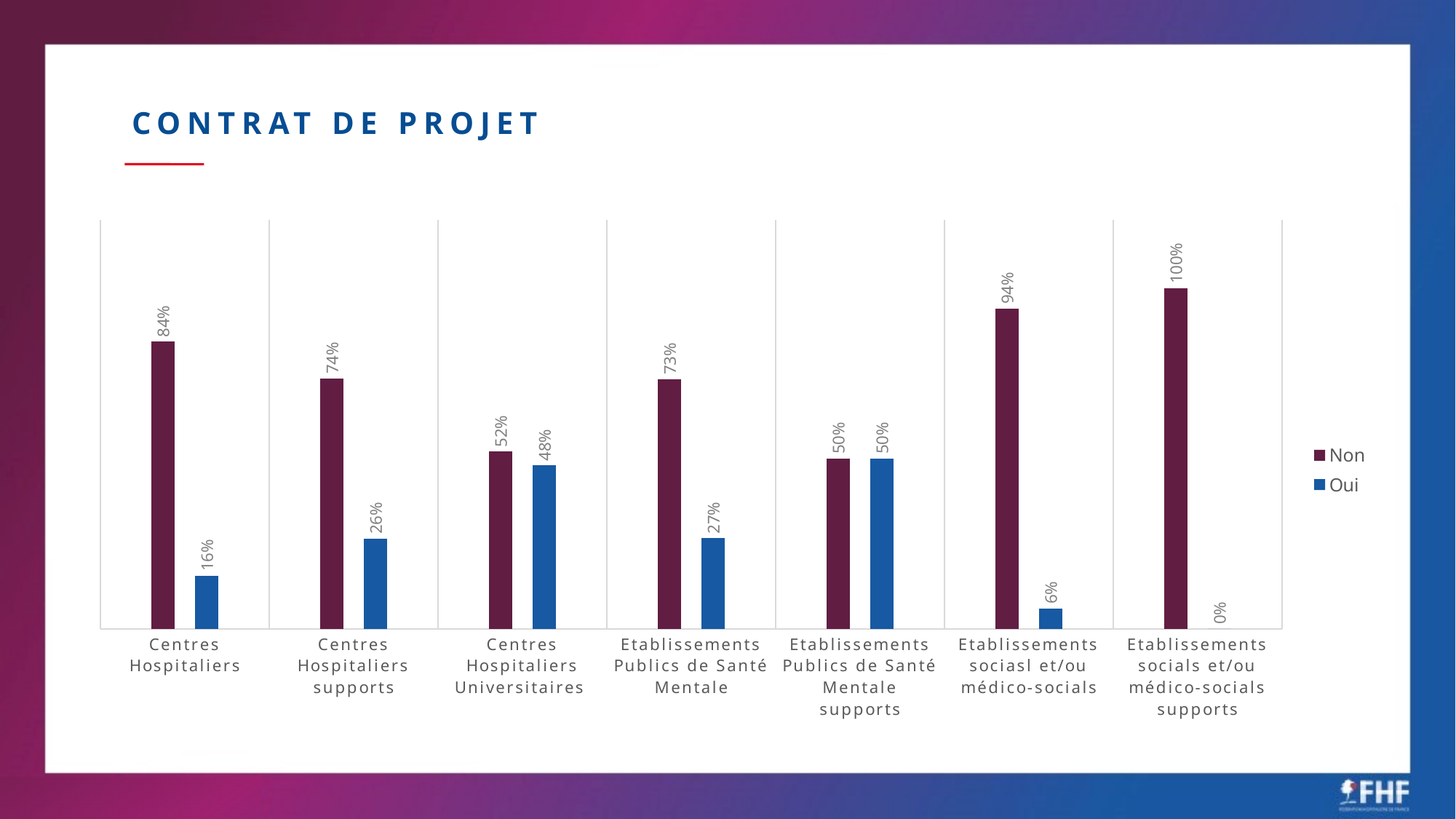
What is the 'Non' value for Centres Hospitaliers? 84% How many series does the legend list? 2 What is the title of the slide? CONTRAT DE PROJET What is the difference between the 'Non' and 'Oui' values for Centres Hospitaliers supports? 48% Which is larger for Etablissements Publics de Santé Mentale: the 'Non' value or the 'Oui' value? Non Which category has the lowest 'Oui' value? Etablissements socials et/ou médico-socials supports Which category has the highest 'Non' value? Etablissements socials et/ou médico-socials supports What is the 'Oui' value for Centres Hospitaliers Universitaires? 48% What is the 'Oui' value for Etablissements sociasl et/ou médico-socials? 6% Which series is shown in blue in the legend? Oui What kind of chart is shown on the slide? Bar chart How many categories are shown on the x axis? 7